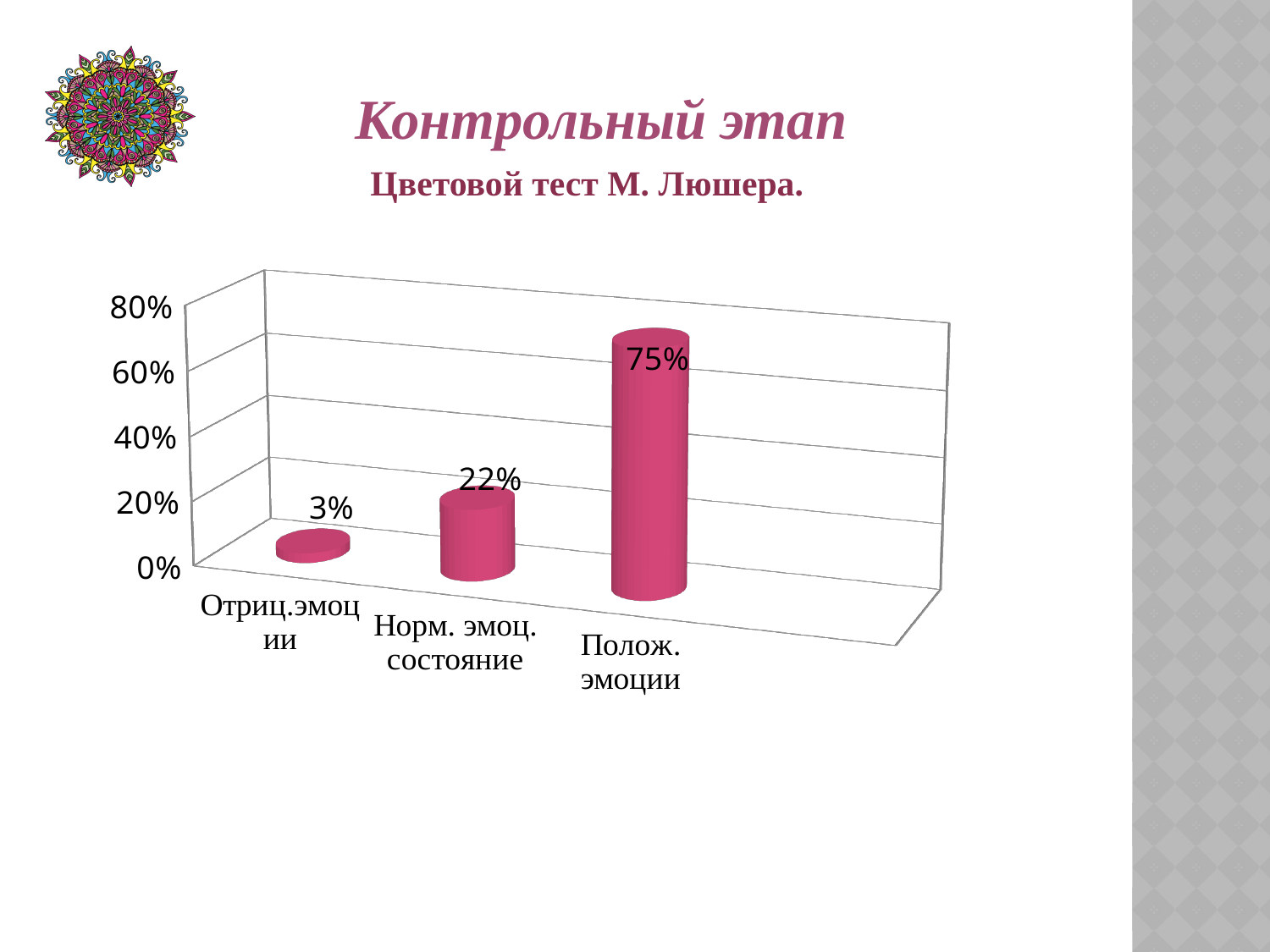
Is the value for Полож. эмоции greater or less than 60%? greater Which category has the highest value? Полож. эмоции What is the value for Норм. эмоц. состояние? 22% What is the difference between the values for Норм. эмоц. состояние and Отриц.эмоции? 19% Which category has the lowest value? Отриц.эмоции What is the value for Полож. эмоции? 75% What kind of chart is shown on the slide? bar chart What is the value for Отриц.эмоции? 3% What is the difference between the values for Полож. эмоции and Норм. эмоц. состояние? 53% How many categories are shown on the chart? 3 Which is larger, the value for Норм. эмоц. состояние or the value for Отриц.эмоции? Норм. эмоц. состояние Do the values rise or fall from left to right along the x axis? rise